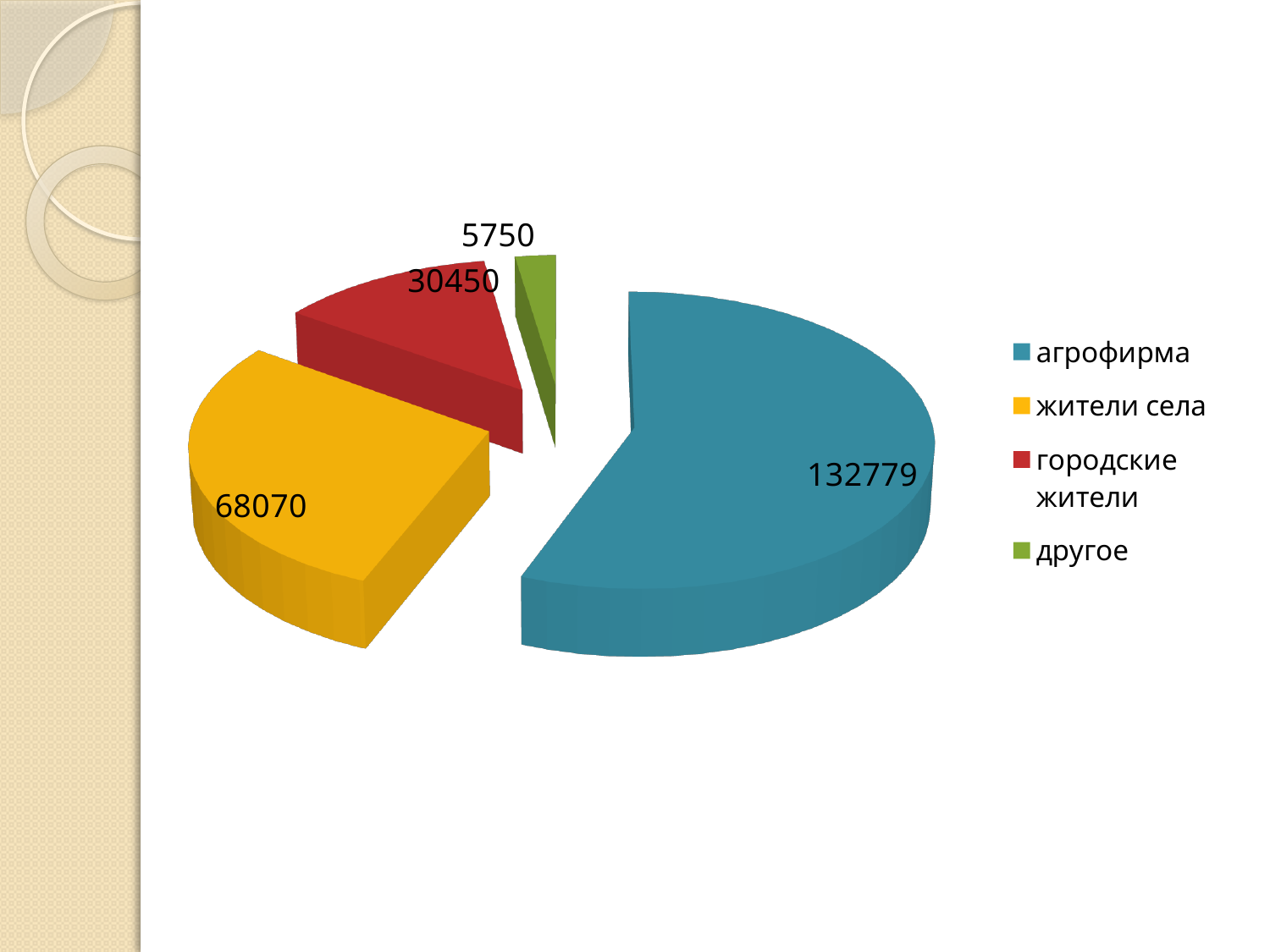
Which category has the smallest slice of the pie? другое What value is shown for городские жители? 30450 Which is larger: the value for жители села or the value for городские жители? жители села What value is shown for жители села? 68070 What is the difference between the values for городские жители and другое? 24700 How many slices does the pie chart have? 4 What value is shown for агрофирма in the pie chart? 132779 What colour is the slice for городские жители? red Which category has the largest slice of the pie? агрофирма What is the difference between the values for агрофирма and жители села? 64709 What value is shown for the другое slice? 5750 What type of chart is shown on the slide? pie chart